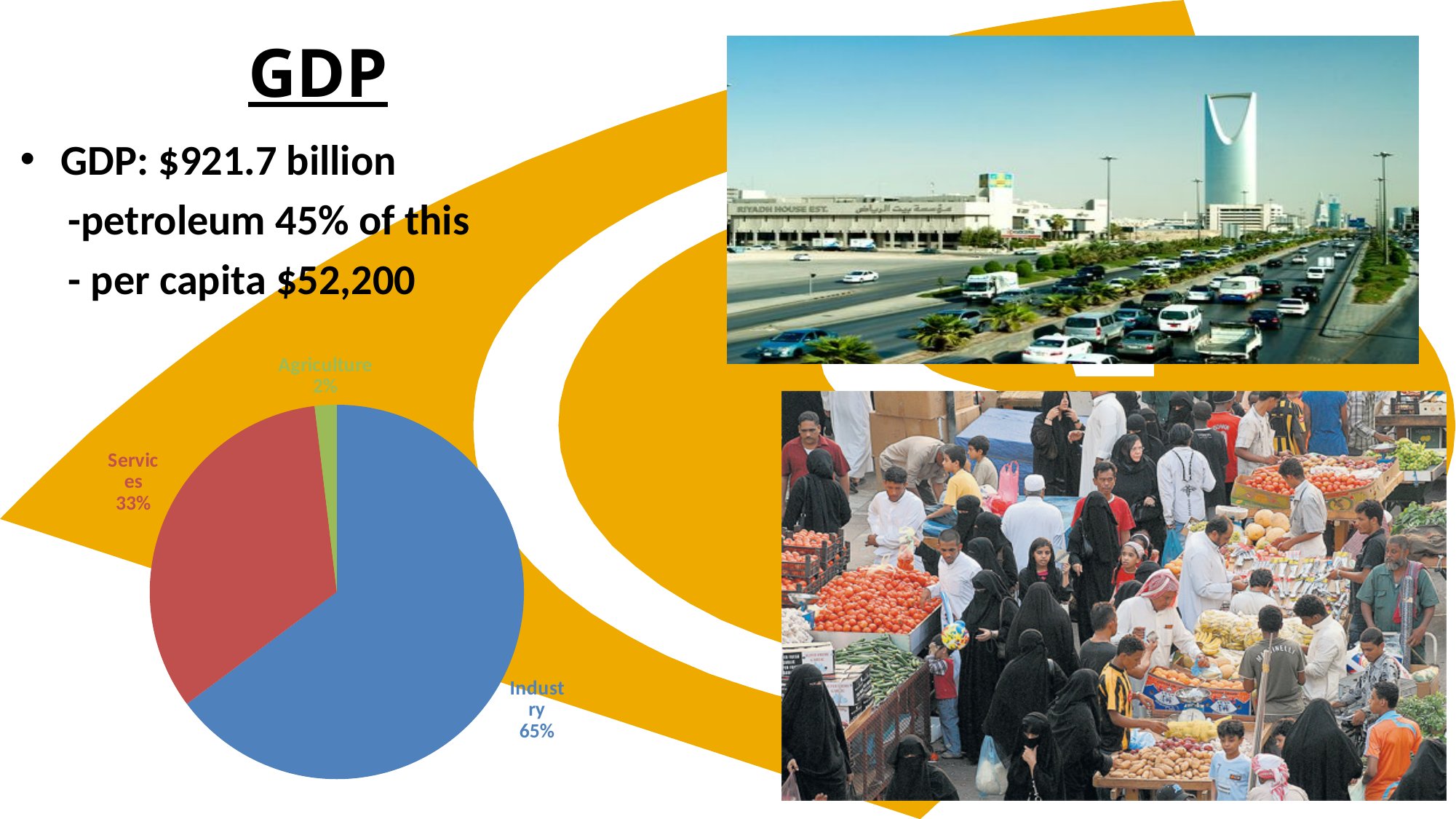
What share of the pie does Industry represent? 65% Which sector has the smallest slice of the pie? Agriculture Which sector has the largest slice of the pie? Industry What share of the pie does Services represent? 33% What is the difference in percentage points between Services and Agriculture? 31 What colour is the Industry slice of the pie? blue What is the difference in percentage points between Industry and Services? 32 What share of the pie does Agriculture represent? 2% How many slices does the pie chart have? 3 What colour is the Services slice of the pie? red What kind of chart is shown on the slide? pie chart Which is larger, the Services slice or the Agriculture slice? Services